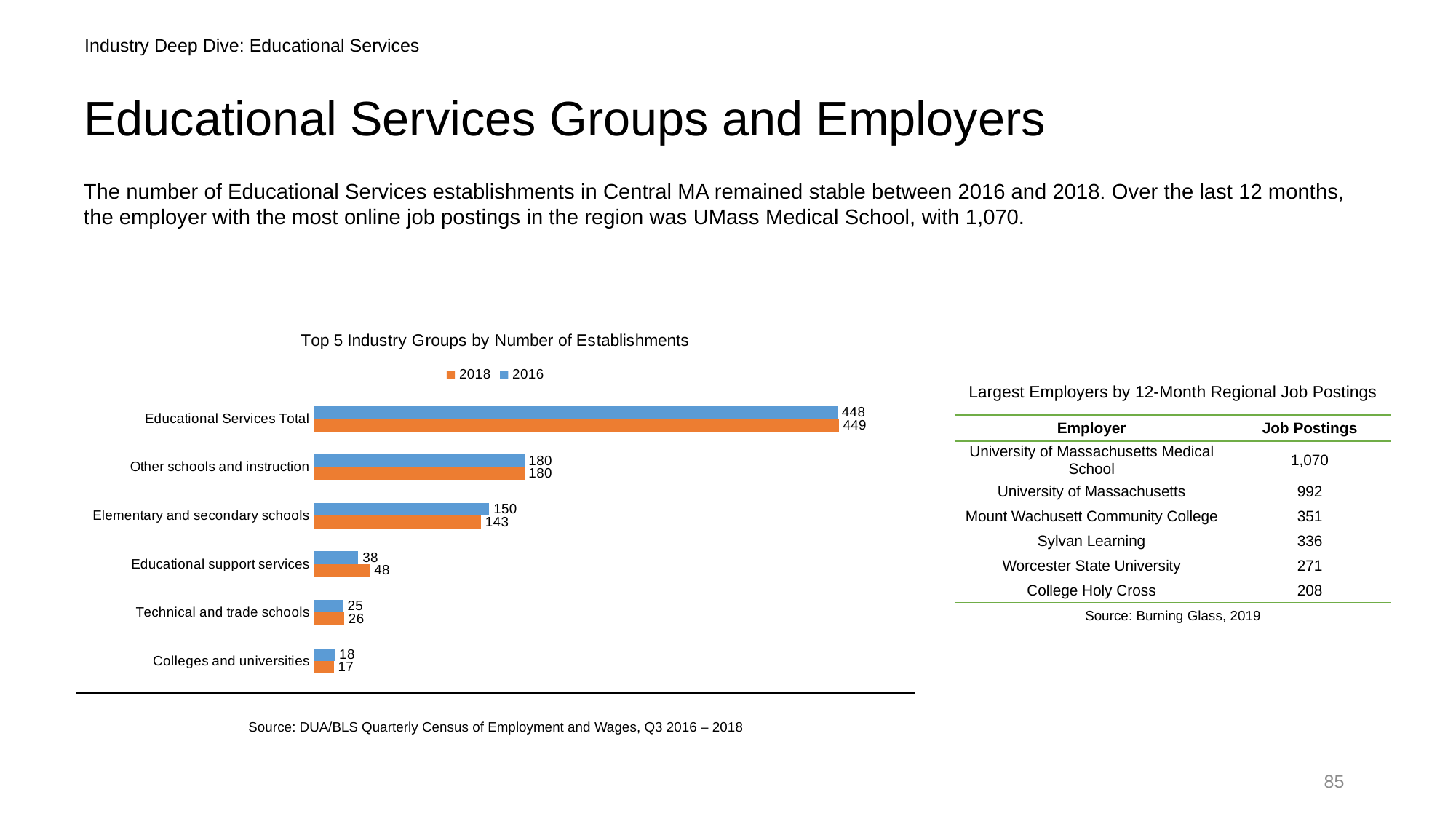
How many categories are plotted in the chart? 6 What is the difference between the 2016 and 2018 values for Educational support services? 10 What is the 2016 value for Colleges and universities? 18 What is the 2016 value for Educational Services Total? 448 What is the 2018 value for Elementary and secondary schools? 143 What is the title of the chart? Top 5 Industry Groups by Number of Establishments How many series does the legend of the chart list? 2 What is the 2018 value for Educational support services? 48 Which category has the lowest number of establishments in 2018? Colleges and universities Excluding the Educational Services Total, which category has the highest number of establishments in 2018? Other schools and instruction Which is larger for Elementary and secondary schools, the 2016 value or the 2018 value? 2016 What type of chart is shown on the slide? bar chart